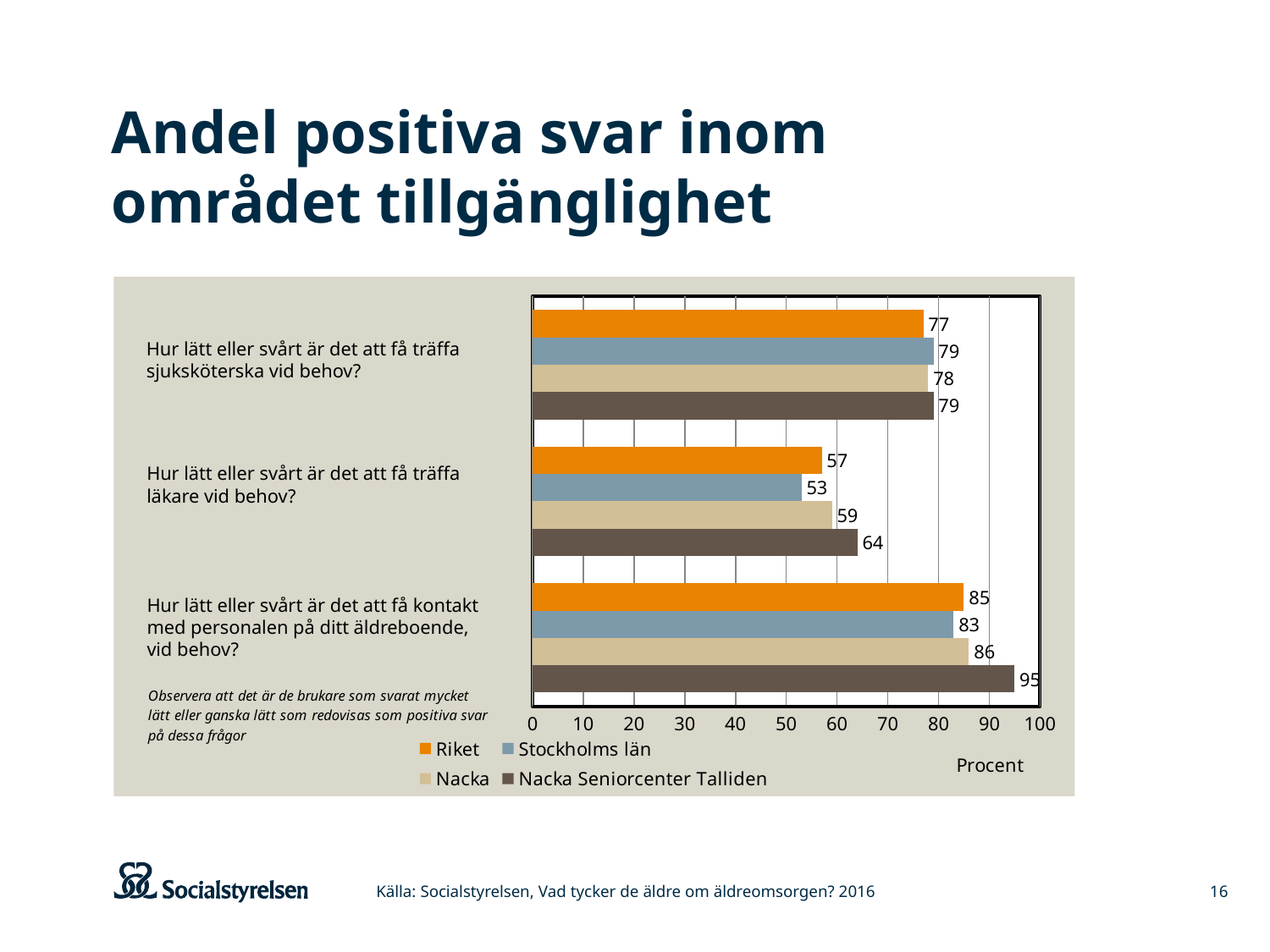
Which is larger on the question about meeting a doctor when needed: Riket or Stockholms län? Riket What is the value for Stockholms län on the question about meeting a nurse when needed ("Hur lätt eller svårt är det att få träffa sjuksköterska vid behov?")? 79 What is the value for Nacka on the question about meeting a doctor when needed? 59 What is the difference between Nacka Seniorcenter Tallliden and Riket on the question about getting in contact with staff at the elderly home? 10 What kind of chart is shown on the slide? Bar chart Which series has the highest value on the question about meeting a doctor when needed? Nacka Seniorcenter Talliden How many series does the legend list? 4 What is the value for Riket on the question about meeting a doctor when needed ("Hur lätt eller svårt är det att få träffa läkare vid behov?")? 57 How many questions (categories) are shown on the chart? 3 What is the value for Nacka Seniorcenter Tallliden on the question about getting in contact with staff at the elderly home ("Hur lätt eller svårt är det att få kontakt med personalen på ditt äldreboende, vid behov?")? 95 Which series has the lowest value on the question about getting in contact with staff at the elderly home? Stockholms län What is the label of the horizontal axis? Procent